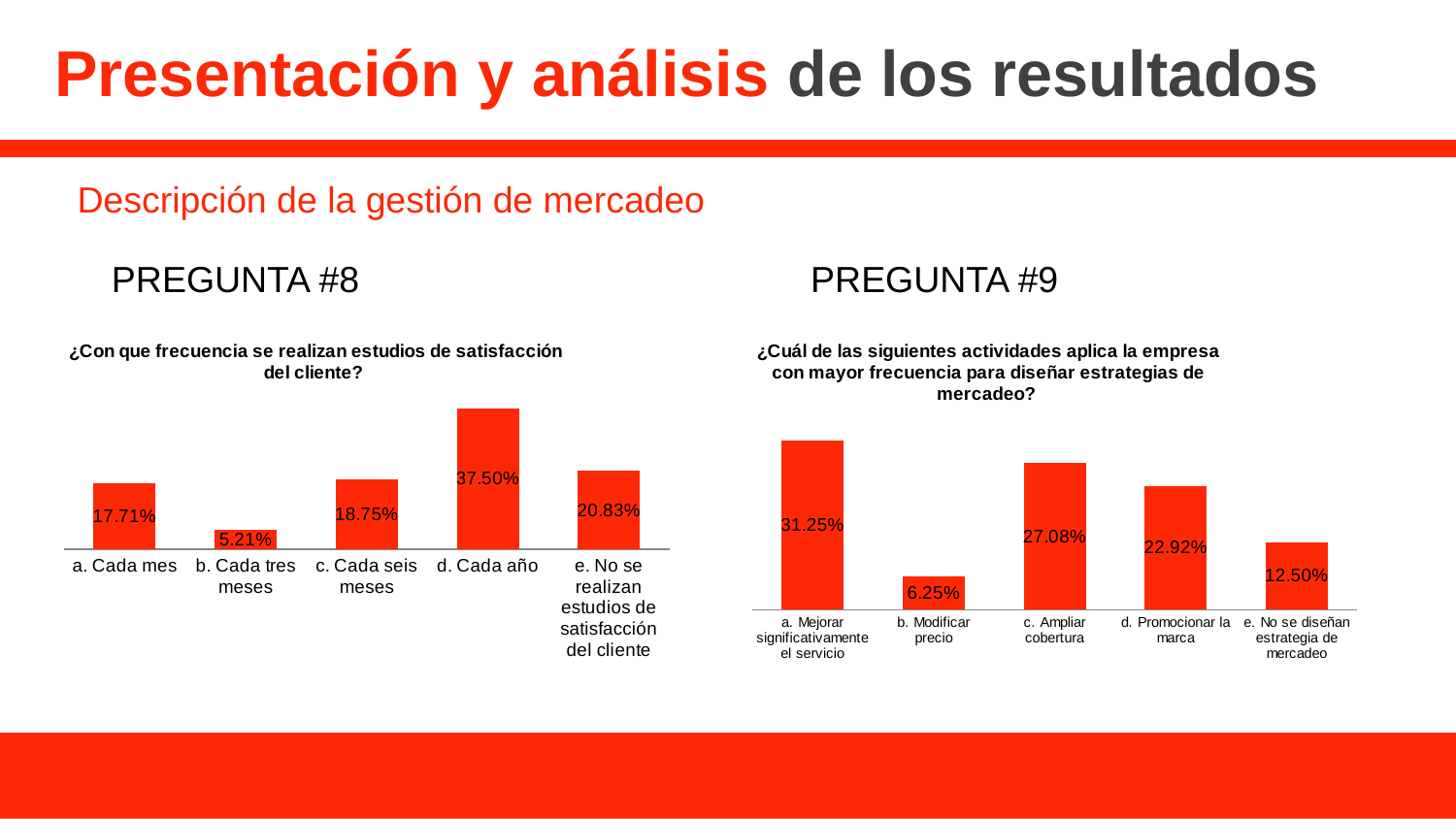
In the PREGUNTA #8 chart, which category has the lowest value? b. Cada tres meses In the PREGUNTA #9 chart, what is the difference between 'd. Promocionar la marca' and 'e. No se diseñan estrategia de mercadeo'? 10.42% In the PREGUNTA #8 chart, what is the value for 'd. Cada año'? 37.50% In the PREGUNTA #9 chart, what is the value for 'c. Ampliar cobertura'? 27.08% What kind of chart is the PREGUNTA #9 chart? Bar chart In the PREGUNTA #8 chart, which is larger: 'e. No se realizan estudios de satisfacción del cliente' or 'c. Cada seis meses'? e. No se realizan estudios de satisfacción del cliente In the PREGUNTA #8 chart, how many categories are shown? 5 In the PREGUNTA #8 chart, what is the difference between 'd. Cada año' and 'a. Cada mes'? 19.79% In the PREGUNTA #9 chart, which category has the lowest value? b. Modificar precio What is the title of the PREGUNTA #8 chart? ¿Con que frecuencia se realizan estudios de satisfacción del cliente? In the PREGUNTA #9 chart, what is the value for 'b. Modificar precio'? 6.25% In the PREGUNTA #9 chart, which category has the highest value? a. Mejorar significativamente el servicio